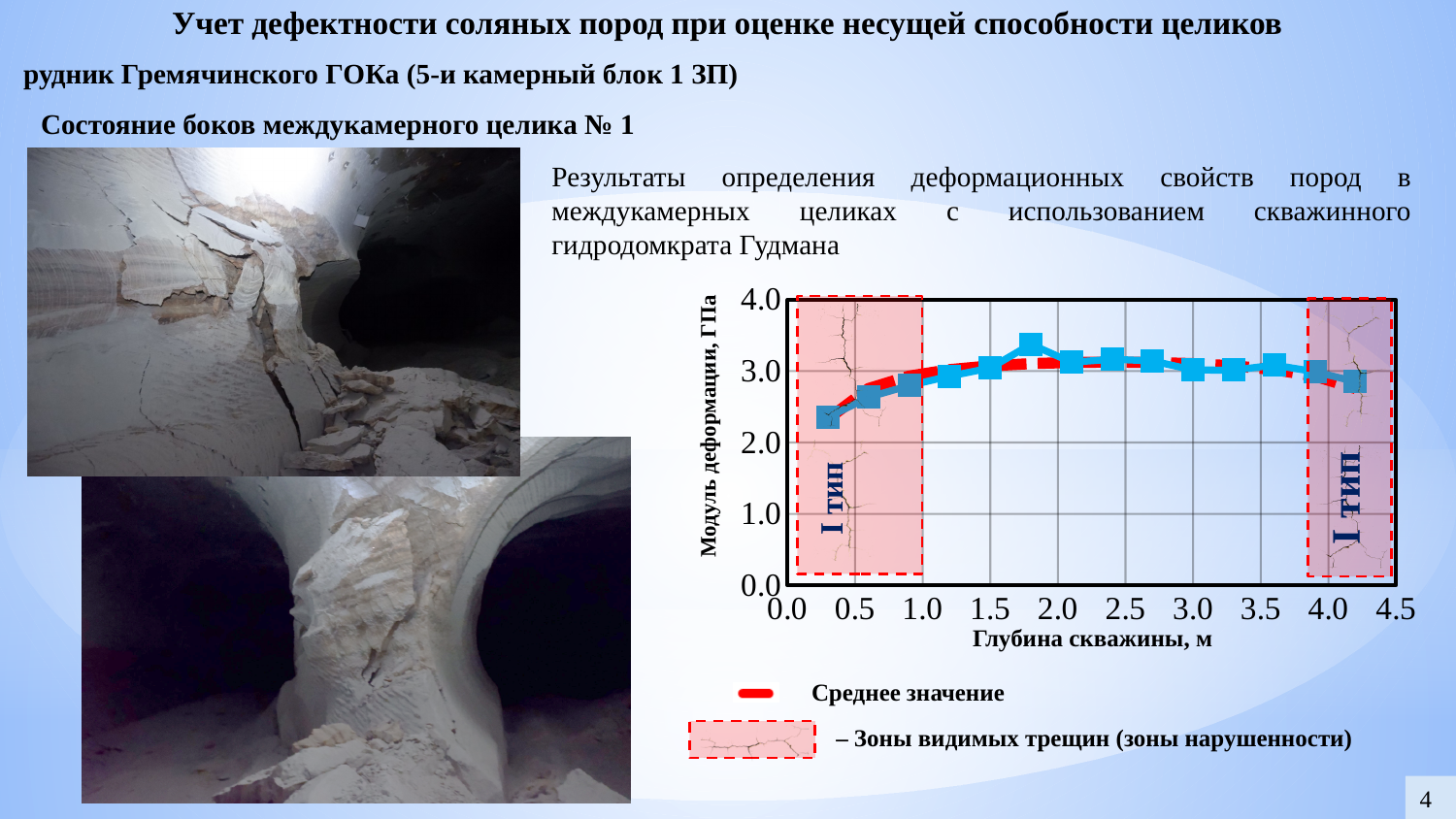
What does the red dashed line in the chart represent, according to the legend? Среднее значение Is the lowest deformation modulus measured at the shallowest or the deepest point of the borehole? shallowest Is the deformation modulus at a borehole depth of about 3.0 m greater or less than 2.0 GPa? greater What is the label of the y axis of the chart? Модуль деформации, ГПа Which is larger: the deformation modulus at about 0.3 m depth or at about 4.2 m depth? at about 4.2 m Do the deformation modulus values rise or fall as borehole depth increases from 0.0 m to 1.5 m? rise What is the highest value shown on the x axis (borehole depth) of the chart? 4.5 Which is larger: the deformation modulus at about 0.3 m depth or at about 1.8 m depth? at about 1.8 m Is the deformation modulus at a borehole depth of about 1.8 m greater or less than 3.0 GPa? greater Is the deformation modulus at a borehole depth of about 0.3 m greater or less than 2.0 GPa? greater What kind of chart is shown on the slide? line chart